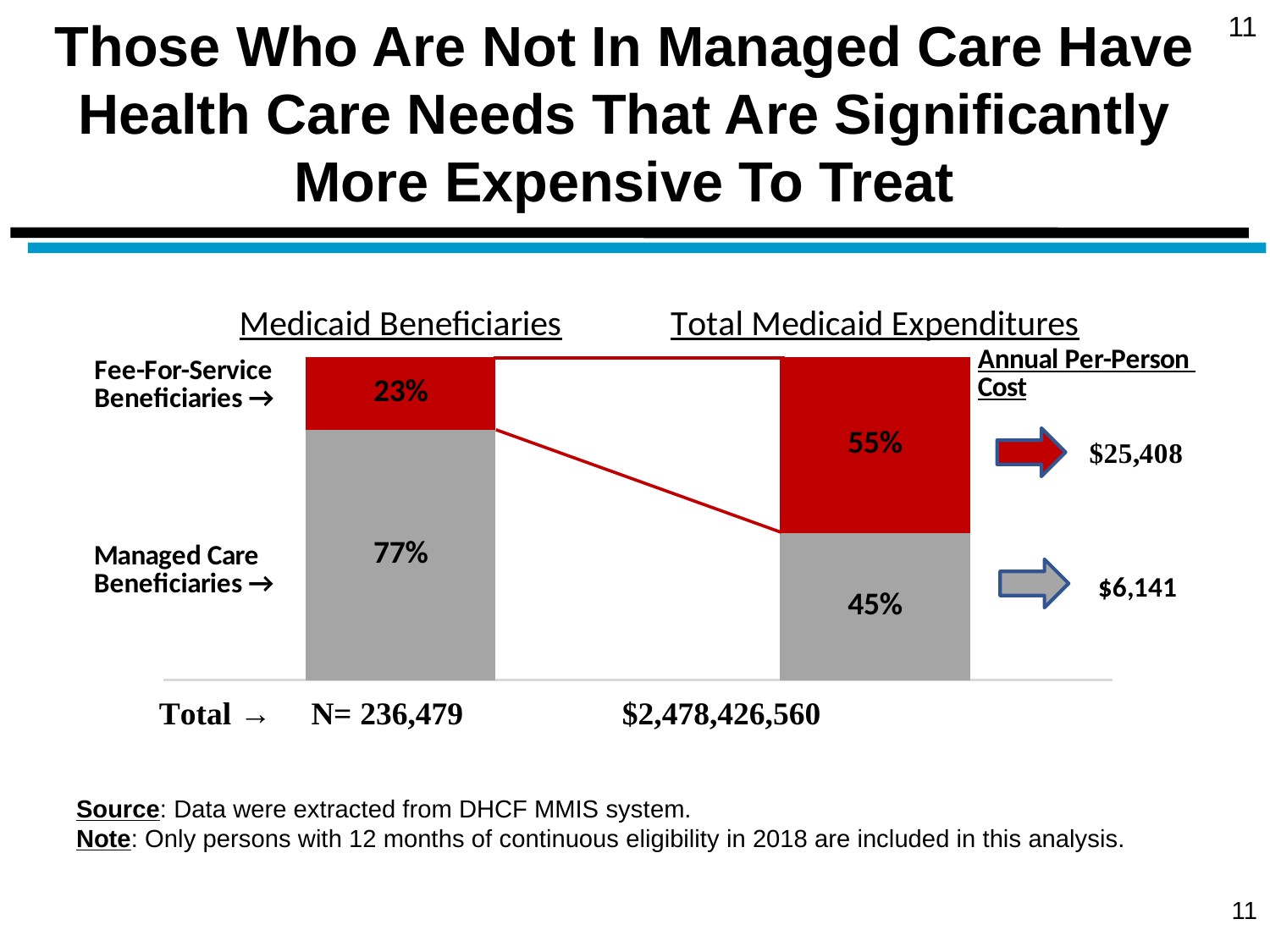
What is the difference in percentage points between the Managed Care share of Medicaid Beneficiaries and the Managed Care share of Total Medicaid Expenditures? 32 percentage points What share of Total Medicaid Expenditures is attributed to Fee-For-Service Beneficiaries? 55% What is the total of Medicaid Expenditures shown below the chart? $2,478,426,560 What share of Total Medicaid Expenditures is attributed to Managed Care Beneficiaries? 45% What kind of chart is used to show Medicaid Beneficiaries and Total Medicaid Expenditures? Stacked bar chart What is the total number of Medicaid Beneficiaries shown below the chart? N= 236,479 Which group has the larger share of Total Medicaid Expenditures, Fee-For-Service or Managed Care Beneficiaries? Fee-For-Service Beneficiaries How many stacked bars are shown in the chart? 2 What is the Annual Per-Person Cost for Managed Care Beneficiaries? $6,141 What is the Annual Per-Person Cost for Fee-For-Service Beneficiaries? $25,408 What share of Medicaid Beneficiaries are Fee-For-Service Beneficiaries? 23% What share of Medicaid Beneficiaries are Managed Care Beneficiaries? 77%